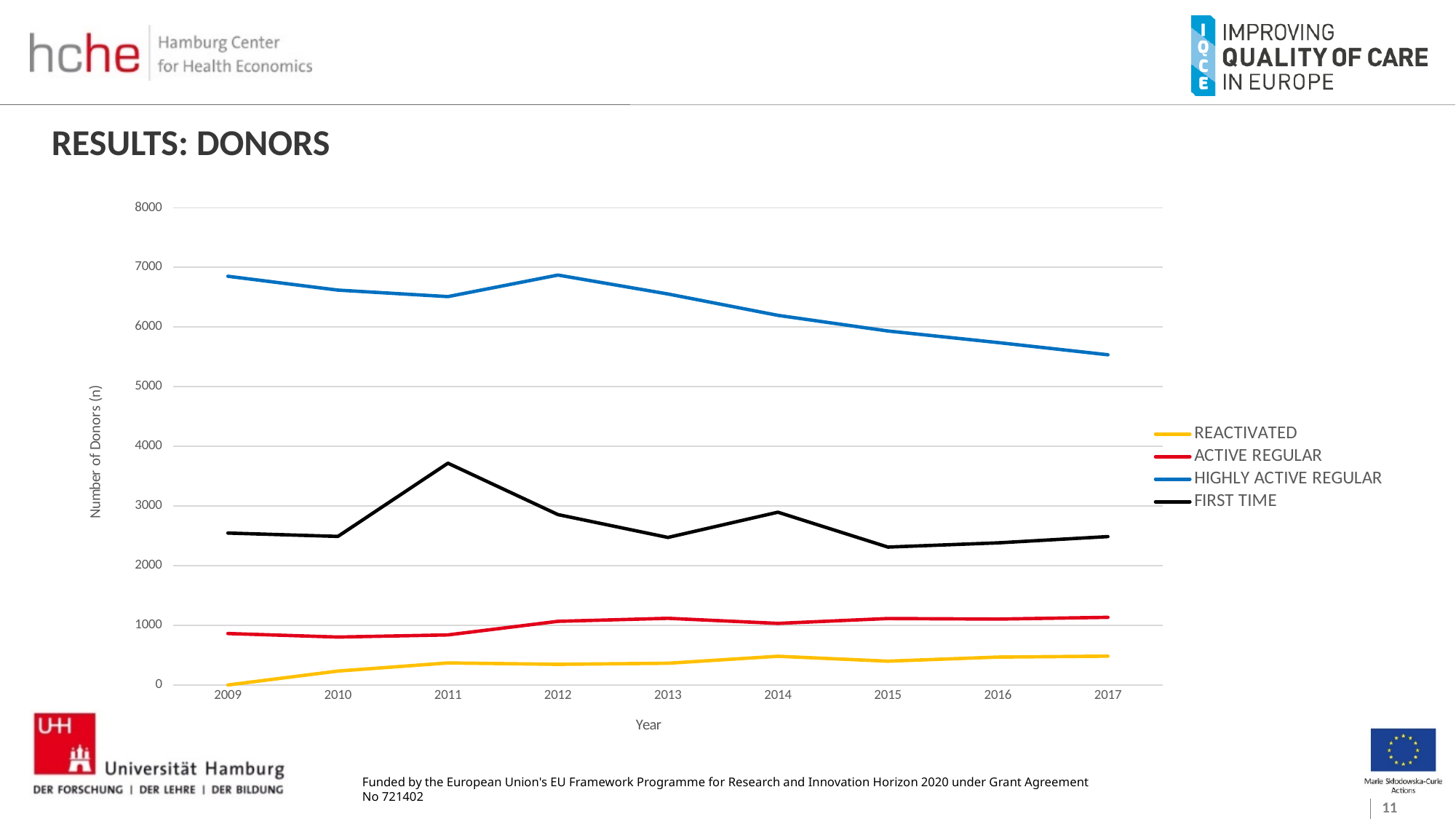
Is the value for HIGHLY ACTIVE REGULAR in 2009 greater or less than 6000? greater Which is larger in 2011, FIRST TIME or ACTIVE REGULAR? FIRST TIME How many series does the legend list? 4 Is the value for FIRST TIME in 2011 greater or less than 3000? greater Does the HIGHLY ACTIVE REGULAR series rise or fall overall from 2009 to 2017? fall Which series has the highest number of donors in 2012? HIGHLY ACTIVE REGULAR How many years are plotted along the x axis? 9 What is the label of the y axis? Number of Donors (n) Which series has the lowest number of donors in 2009? REACTIVATED In which year does the FIRST TIME series reach its peak? 2011 What kind of chart is shown on the slide? Line chart Is the value for HIGHLY ACTIVE REGULAR in 2017 greater or less than 6000? less